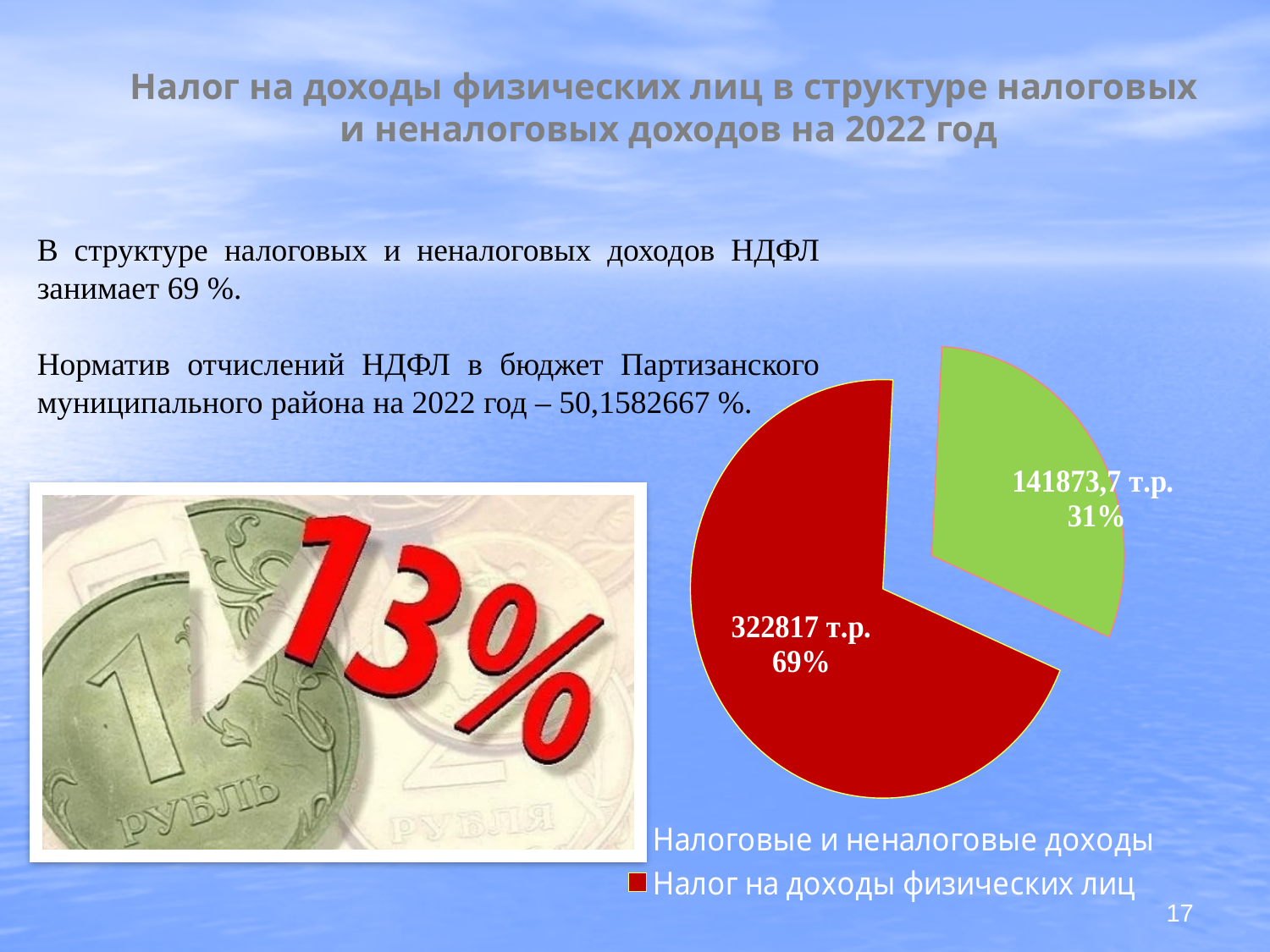
What value is shown for the slice labelled 'Налоговые и неналоговые доходы' in the pie chart? 141873,7 т.р. What value is shown for the slice labelled 'Налог на доходы физических лиц' in the pie chart? 322817 т.р. What is the difference between the two values shown in the pie chart (322817 т.р. and 141873,7 т.р.)? 180943,3 т.р. What colour is the slice for 'Налог на доходы физических лиц' in the pie chart? red Which slice of the pie chart is the smallest? Налоговые и неналоговые доходы How many slices does the pie chart have? 2 Which is larger in the pie chart: 'Налог на доходы физических лиц' or 'Налоговые и неналоговые доходы'? Налог на доходы физических лиц What share of the pie does the 'Налоговые и неналоговые доходы' slice take? 31% How many entries does the legend of the pie chart list? 2 What share of the pie does the 'Налог на доходы физических лиц' slice take? 69% What kind of chart is shown on the slide? pie chart Which slice of the pie chart is the largest? Налог на доходы физических лиц